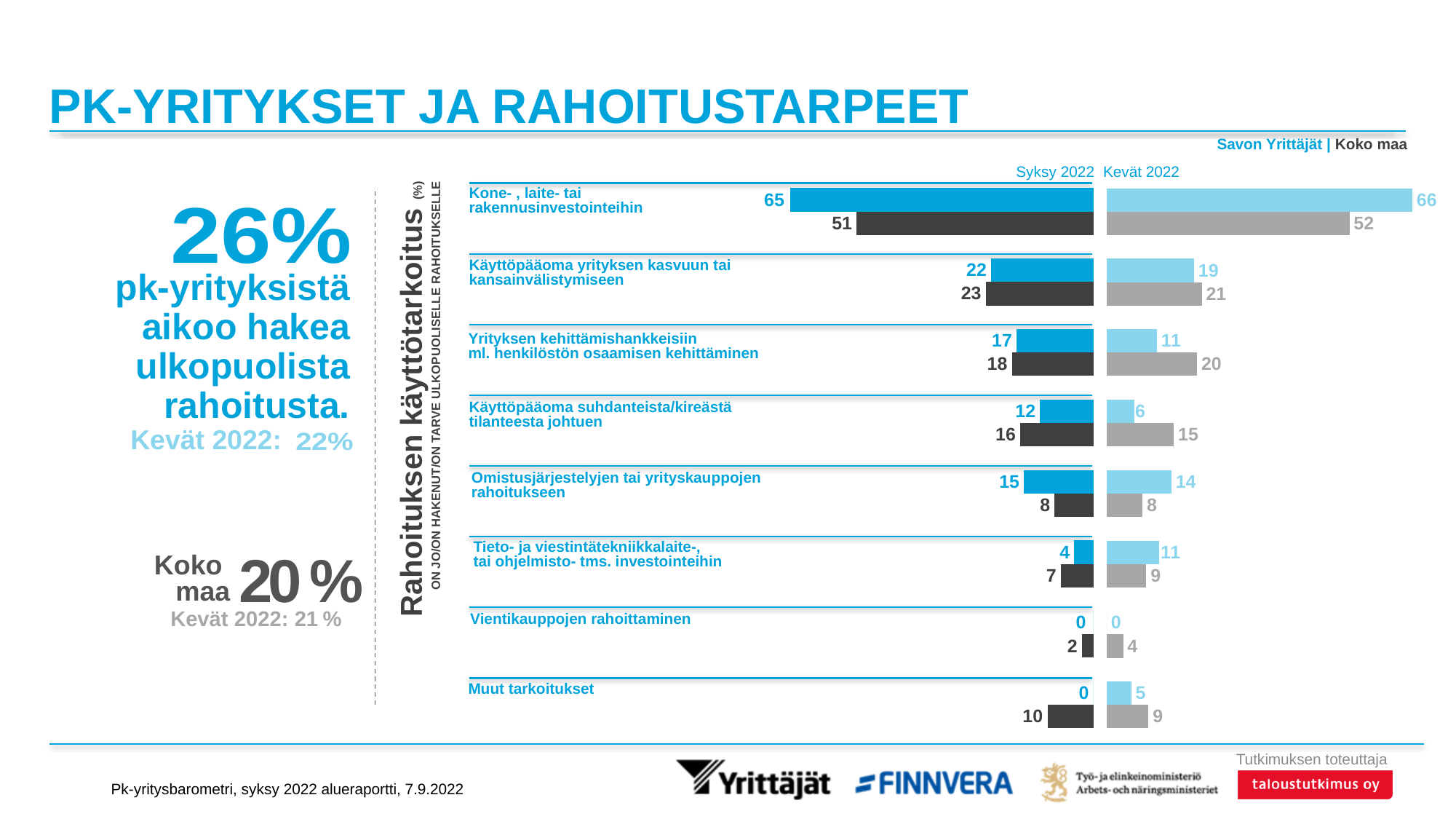
In the Kevät 2022 chart, what is the Koko maa value for 'Vientikauppojen rahoittaminen'? 4 In the Syksy 2022 chart, which is larger for 'Omistusjärjestelyjen tai yrityskauppojen rahoitukseen': the Savon Yrittäjät value or the Koko maa value? Savon Yrittäjät Which two time periods are compared in the chart? Syksy 2022 and Kevät 2022 How many categories are shown in the chart? 8 In the Syksy 2022 chart, what is the difference between the Savon Yrittäjät and Koko maa values for 'Kone-, laite- tai rakennusinvestointeihin'? 14 In the Kevät 2022 chart, what is the Savon Yrittäjät value for 'Yrityksen kehittämishankkeisiin ml. henkilöstön osaamisen kehittäminen'? 11 What kind of chart is used on the slide? Bar chart In the Kevät 2022 chart, what is the difference between the Koko maa and Savon Yrittäjät values for 'Käyttöpääoma suhdanteista/kireästä tilanteesta johtuen'? 9 In the Syksy 2022 chart, which category has the lowest Koko maa value? Vientikauppojen rahoittaminen In the Syksy 2022 chart, which category has the highest Savon Yrittäjät value? Kone-, laite- tai rakennusinvestointeihin In the Syksy 2022 chart, what is the Koko maa value for 'Käyttöpääoma yrityksen kasvuun tai kansainvälistymiseen'? 23 In the Syksy 2022 chart, what is the value for Savon Yrittäjät for 'Kone-, laite- tai rakennusinvestointeihin'? 65